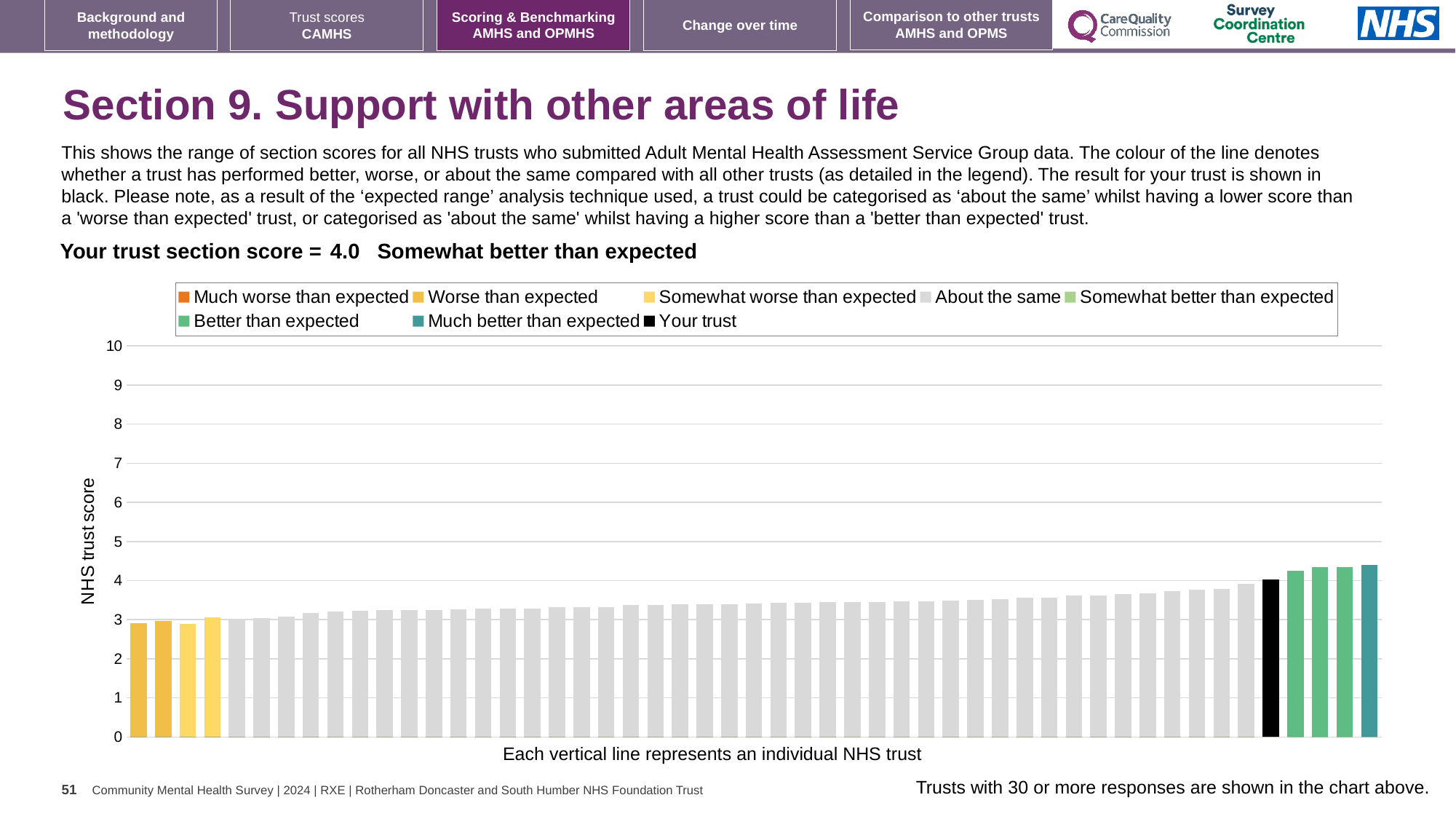
Do the bar values rise or fall from left to right along the x axis? rise What kind of chart is shown on the slide? bar chart What is the section score for your trust shown on the slide? 4.0 Which legend category does the tallest bar in the chart belong to? Much better than expected Is the shortest bar in the chart greater or less than 2? greater Is the tallest bar in the chart greater or less than 5? less Is the value of the black 'Your trust' bar greater or less than 3? greater What is the label on the vertical axis of the chart? NHS trust score How many entries does the chart legend list? 8 How many bars are coloured black for 'Your trust'? 1